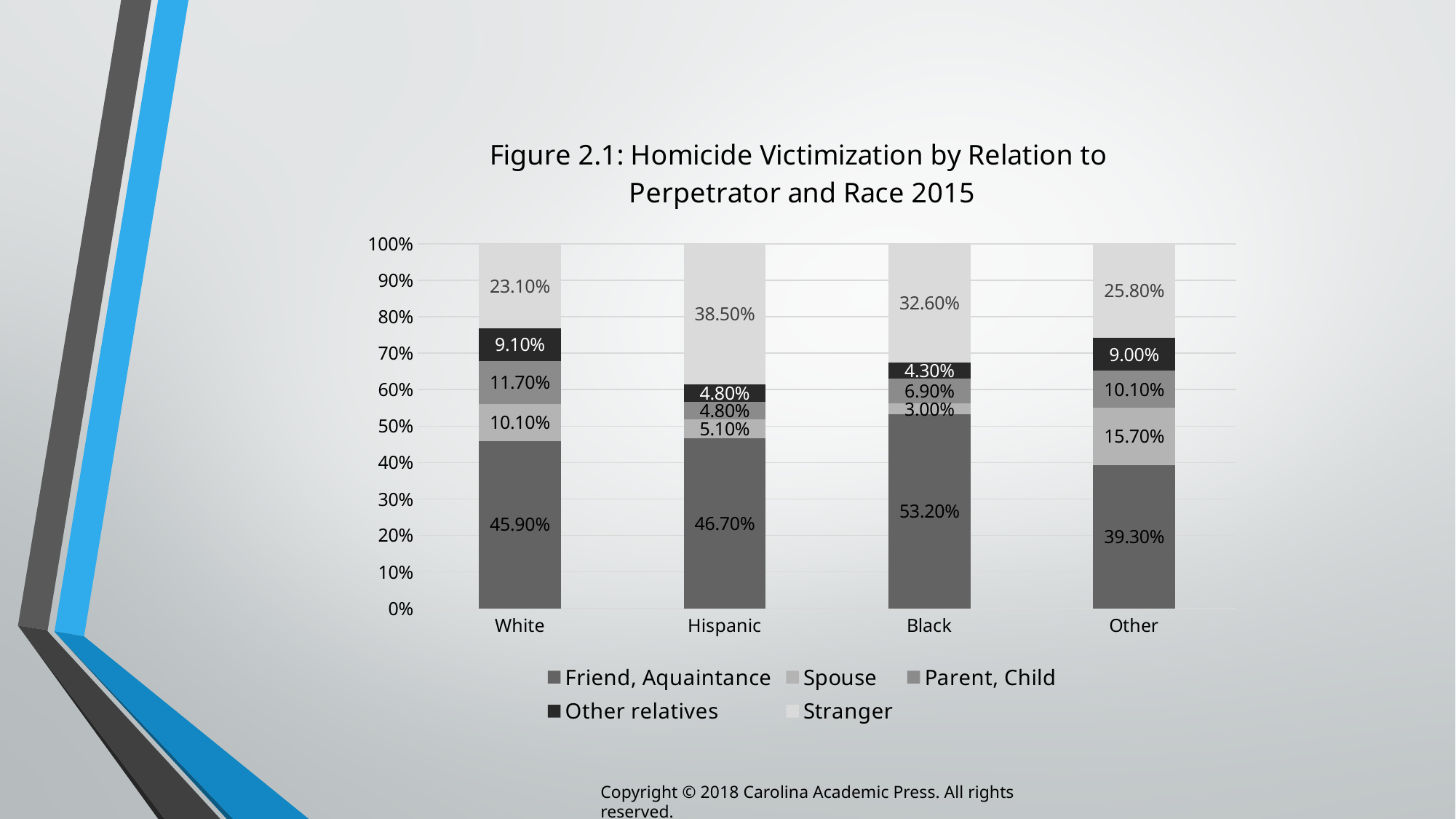
How many series does the legend list? 5 What kind of chart is shown on the slide? Stacked bar chart Which race category has the highest Friend, Aquaintance value? Black What is the title of the chart? Figure 2.1: Homicide Victimization by Relation to Perpetrator and Race 2015 Which race category has the lowest Spouse value? Black What is the Friend, Aquaintance value for Black? 53.20% How many race categories are shown on the x axis? 4 What is the difference between the Stranger values for Hispanic and White? 15.40% What is the Stranger value for Hispanic? 38.50% What is the Other relatives value for White? 9.10% Which is larger, the Parent, Child value for White or for Black? White What is the Spouse value for Other? 15.70%